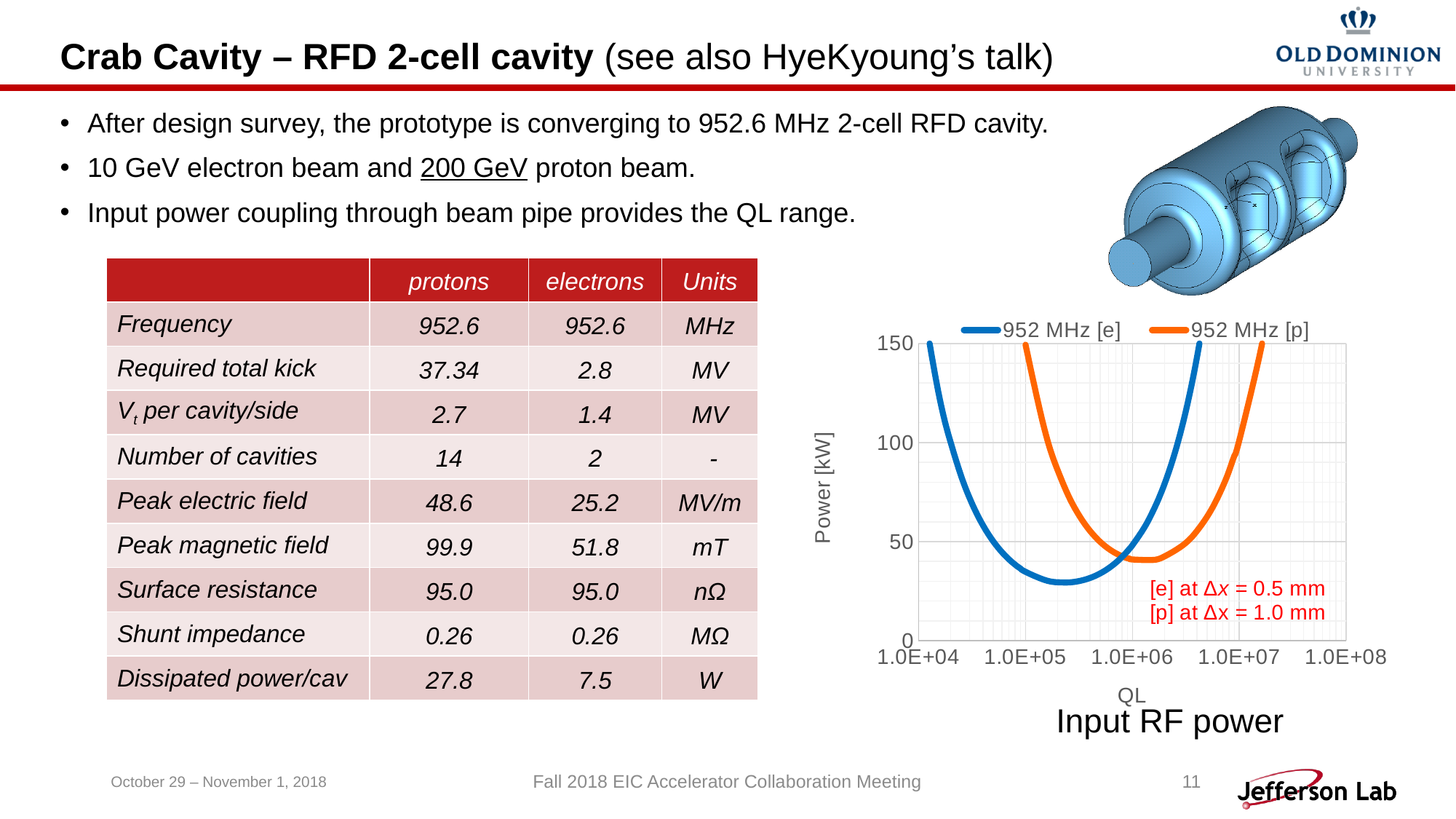
In the "Input RF power" chart, is the minimum value of the 952 MHz [p] curve greater or less than 50? less In the "Input RF power" chart, how does the 952 MHz [e] curve behave as QL increases from 1.0E+04 to 1.0E+07? falls then rises In the "Input RF power" chart, is the value of the 952 MHz [p] curve at QL = 1.0E+05 greater or less than 100? greater How many series does the legend of the "Input RF power" chart list? 2 In the "Input RF power" chart, is the value of the 952 MHz [e] curve at QL = 1.0E+05 greater or less than 50? less What kind of chart is the "Input RF power" chart? line chart What are the two series named in the legend of the "Input RF power" chart? 952 MHz [e] and 952 MHz [p] In the "Input RF power" chart, which series reaches the lower minimum power, 952 MHz [e] or 952 MHz [p]? 952 MHz [e] What is the highest tick value shown on the y axis of the "Input RF power" chart? 150 In the "Input RF power" chart, which series reaches its minimum at a higher QL, 952 MHz [e] or 952 MHz [p]? 952 MHz [p] What is the label of the y axis of the "Input RF power" chart? Power [kW]